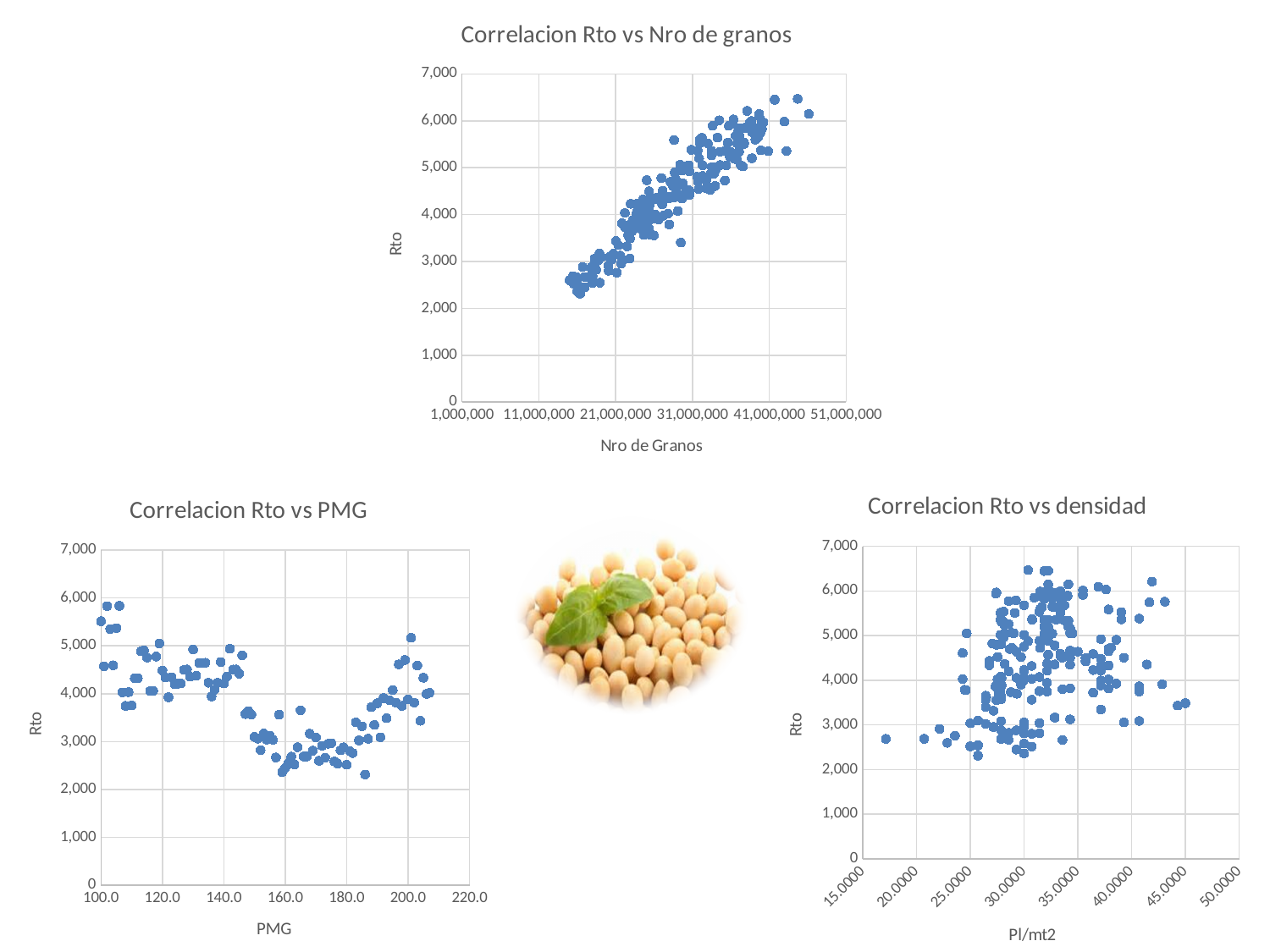
In the "Correlacion Rto vs PMG" chart, is the lowest Rto value greater or less than 3,000? less What kind of chart is "Correlacion Rto vs densidad"? scatter chart What is the x-axis title of the "Correlacion Rto vs densidad" chart? Pl/mt2 In the "Correlacion Rto vs PMG" chart, do Rto values generally rise or fall as PMG increases from 100.0 to 160.0? fall In the "Correlacion Rto vs Nro de granos" chart, is the lowest Rto value greater or less than 3,000? less What kind of chart is "Correlacion Rto vs Nro de granos"? scatter chart What is the x-axis title of the "Correlacion Rto vs Nro de granos" chart? Nro de Granos In the "Correlacion Rto vs densidad" chart, is the highest Rto value greater or less than 6,000? greater In the "Correlacion Rto vs Nro de granos" chart, do Rto values rise or fall as Nro de Granos increases? rise How many charts are shown on the slide? 3